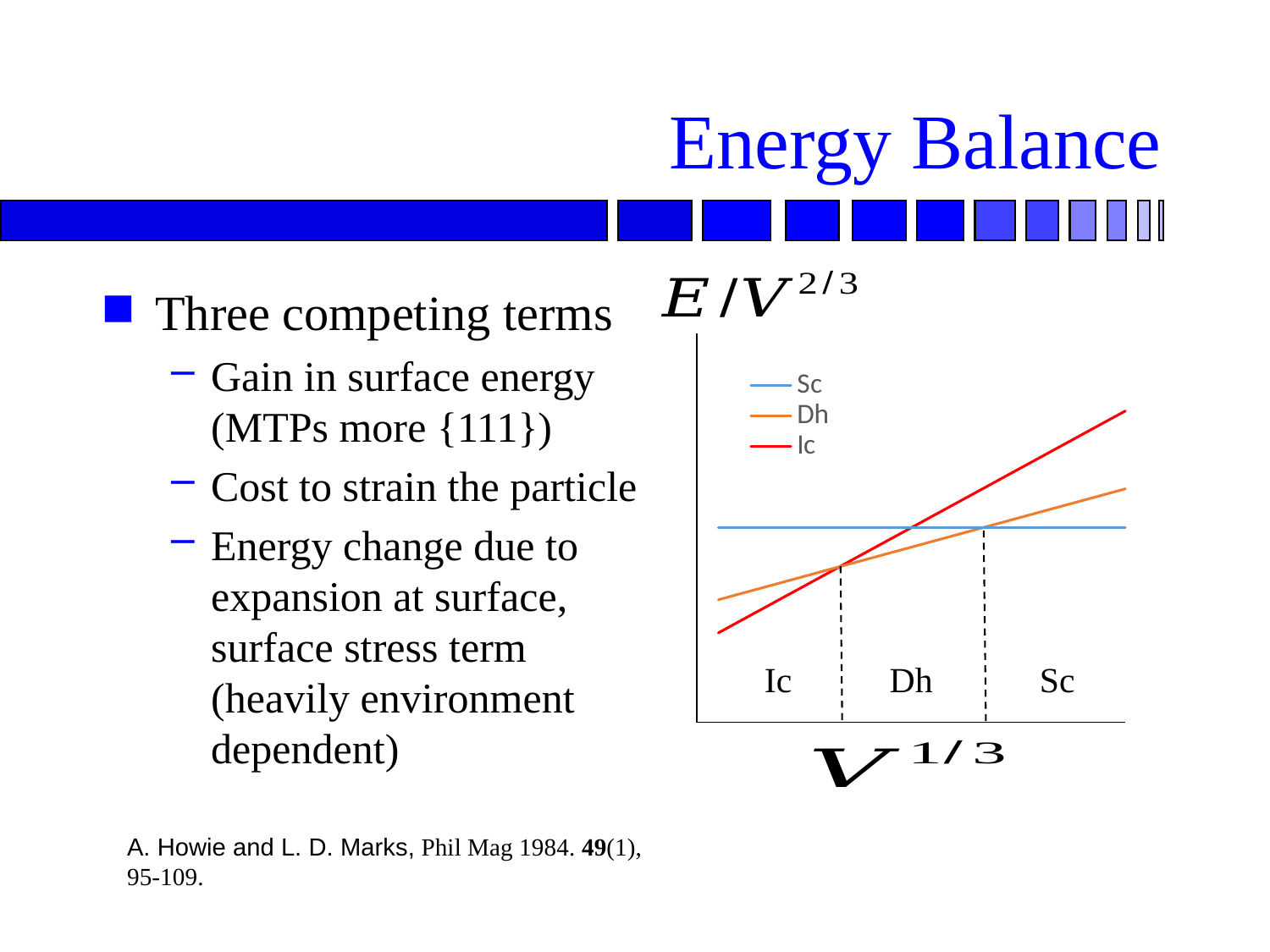
Does the Dh line rise or fall as V^(1/3) increases? rise What is the label on the chart's vertical axis? E/V^(2/3) How many regions are labelled along the x axis of the chart? 3 Does the Sc line rise, fall, or stay flat as V^(1/3) increases? stay flat Which series are listed in the chart's legend? Sc, Dh, Ic What kind of chart is shown on the slide? line chart Does the Ic line rise or fall as V^(1/3) increases? rise Which series has the highest value at the right end of the chart? Ic At the left end of the chart, which is larger, the Sc line or the Dh line? Sc How many series does the chart's legend list? 3 Which series has the lowest value at the left end of the chart? Ic At the right end of the chart, which is larger, the Ic line or the Sc line? Ic